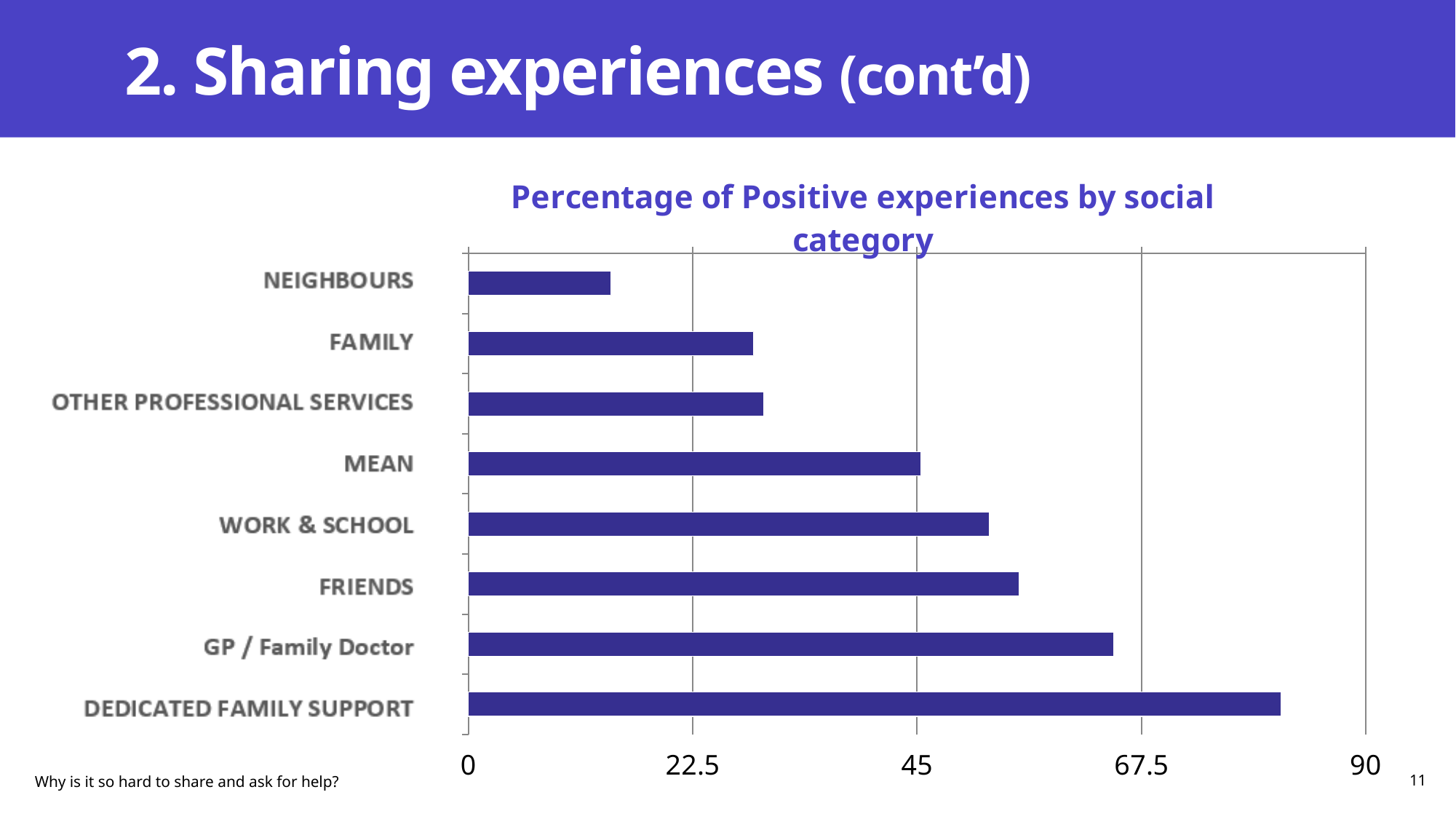
Which category has the highest percentage of positive experiences? DEDICATED FAMILY SUPPORT Which has a higher value, GP / Family Doctor or WORK & SCHOOL? GP / Family Doctor Which has a higher value, FRIENDS or FAMILY? FRIENDS What is the title of the chart? Percentage of Positive experiences by social category What kind of chart is shown on the slide? bar chart Is the value for GP / Family Doctor greater or less than 67.5? less Is the value for NEIGHBOURS greater or less than 22.5? less Is the value for FAMILY greater or less than 22.5? greater Which category has the lowest percentage of positive experiences? NEIGHBOURS How many categories are plotted in the chart? 8